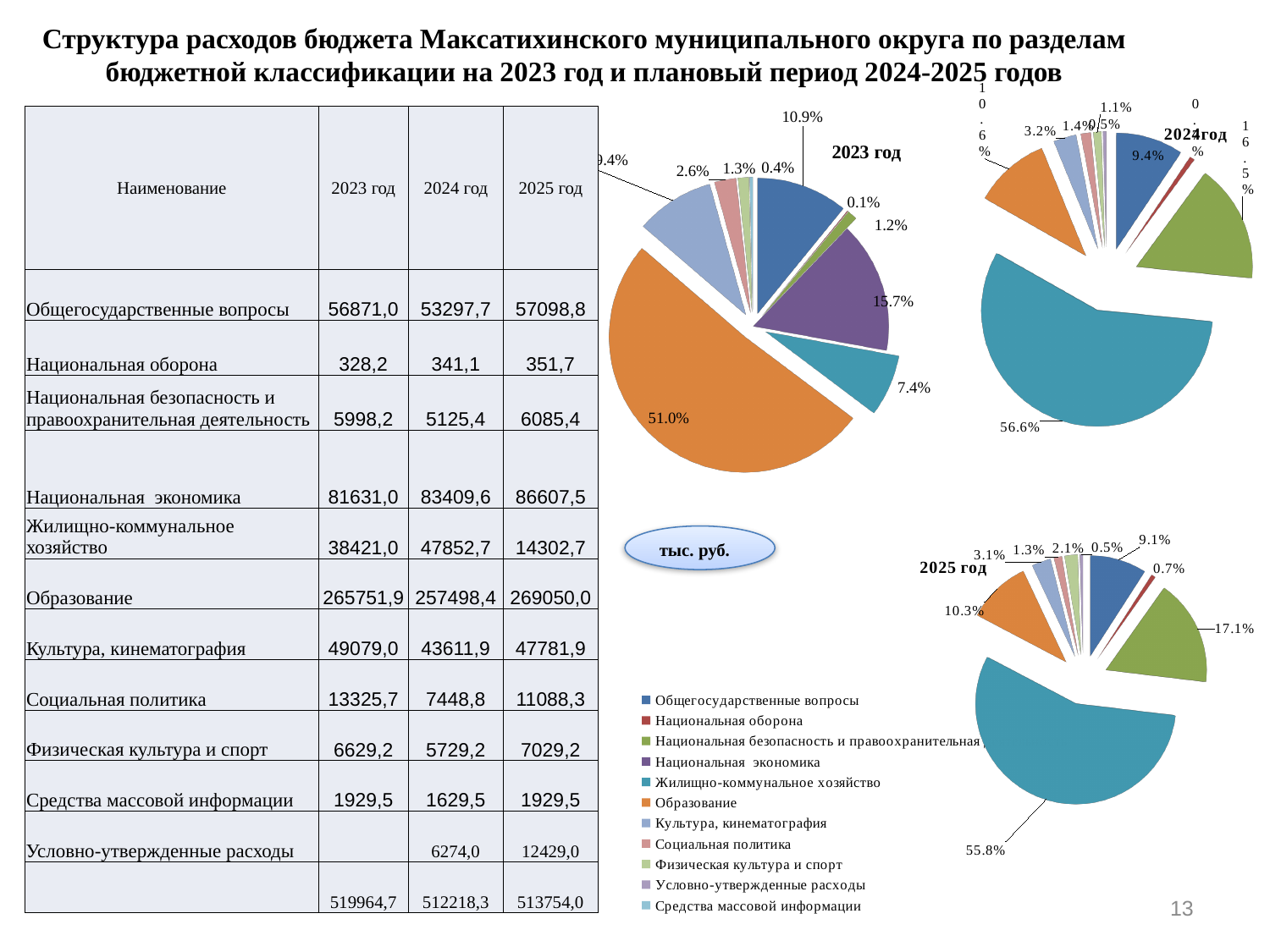
Which is larger: the largest slice in the 2024 год pie chart or the largest slice in the 2025 год pie chart? 2024 год (56.6%) In the 2023 год pie chart, what share is shown for Общегосударственные вопросы (the dark blue slice)? 10.9% In the 2023 год pie chart, what share is shown for Жилищно-коммунальное хозяйство (the teal slice)? 7.4% In the 2023 год pie chart, what is the share of the largest slice? 51.0% In the 2023 год pie chart, what is the difference between the Образование slice and the Национальная экономика slice? 35.3% In the 2023 год pie chart, what share is shown for Образование (the orange slice)? 51.0% What kind of charts are shown on the slide? Pie charts In the 2025 год pie chart, what is the share of the largest slice? 55.8% In the 2024 год pie chart, what is the share of the largest slice? 56.6% How many entries does the legend list? 11 How many pie charts are on the slide? 3